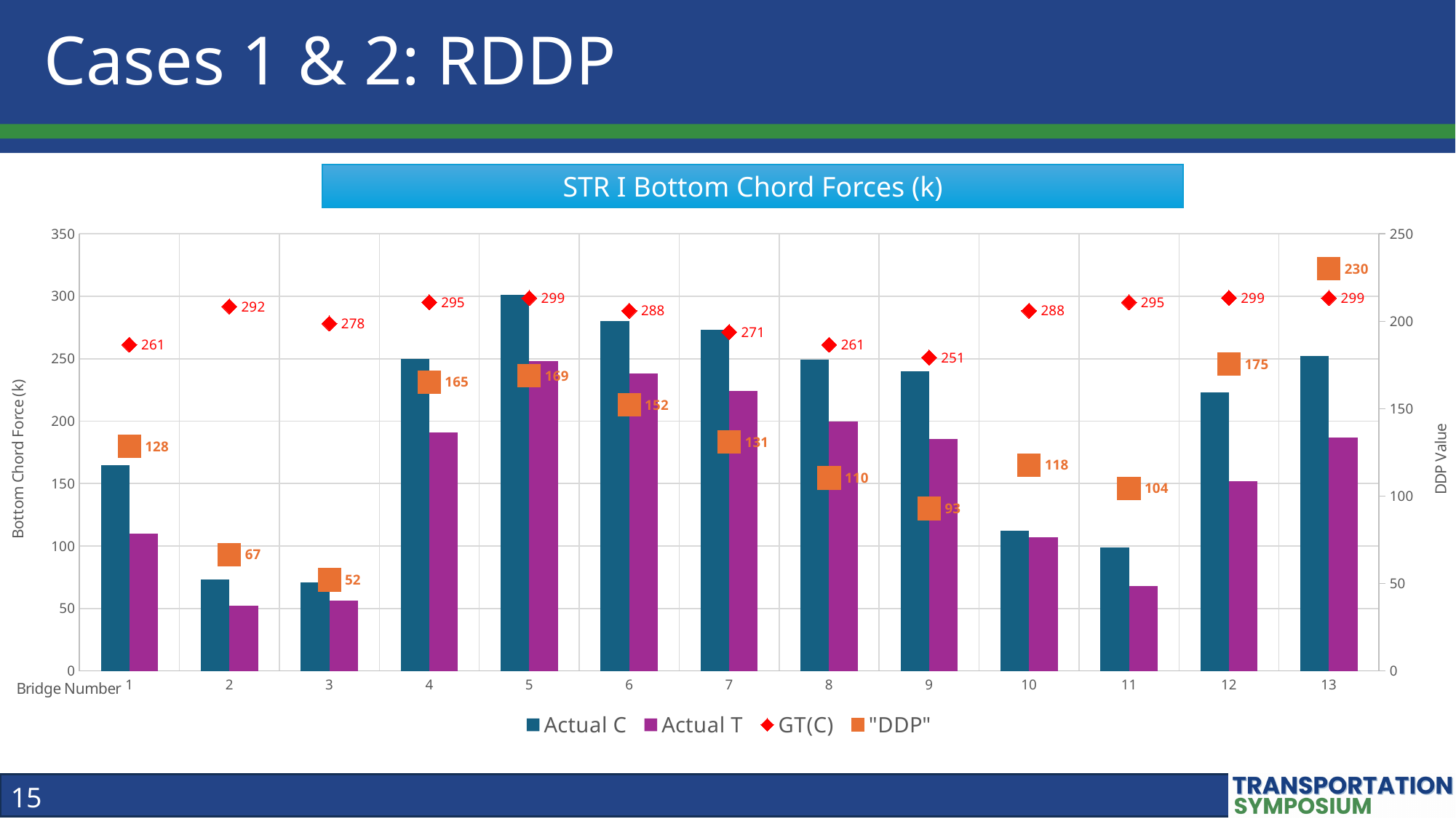
What is the GT(C) value for bridge number 2? 292 Which bridge number has the highest "DDP" value? 13 Which is larger, the "DDP" value for bridge 4 or for bridge 6? Bridge 4 What is the difference between the GT(C) value and the "DDP" value for bridge number 2? 225 What is the "DDP" value for bridge number 7? 131 What is the GT(C) value for bridge number 9? 251 Which bridge number has the lowest GT(C) value? 9 Is the Actual C value for bridge number 12 greater or less than 200? greater Is the Actual T value for bridge number 11 greater or less than 100? less How many bridge numbers are shown on the x axis? 13 How many series does the legend list? 4 Which bridge number has the lowest "DDP" value? 3